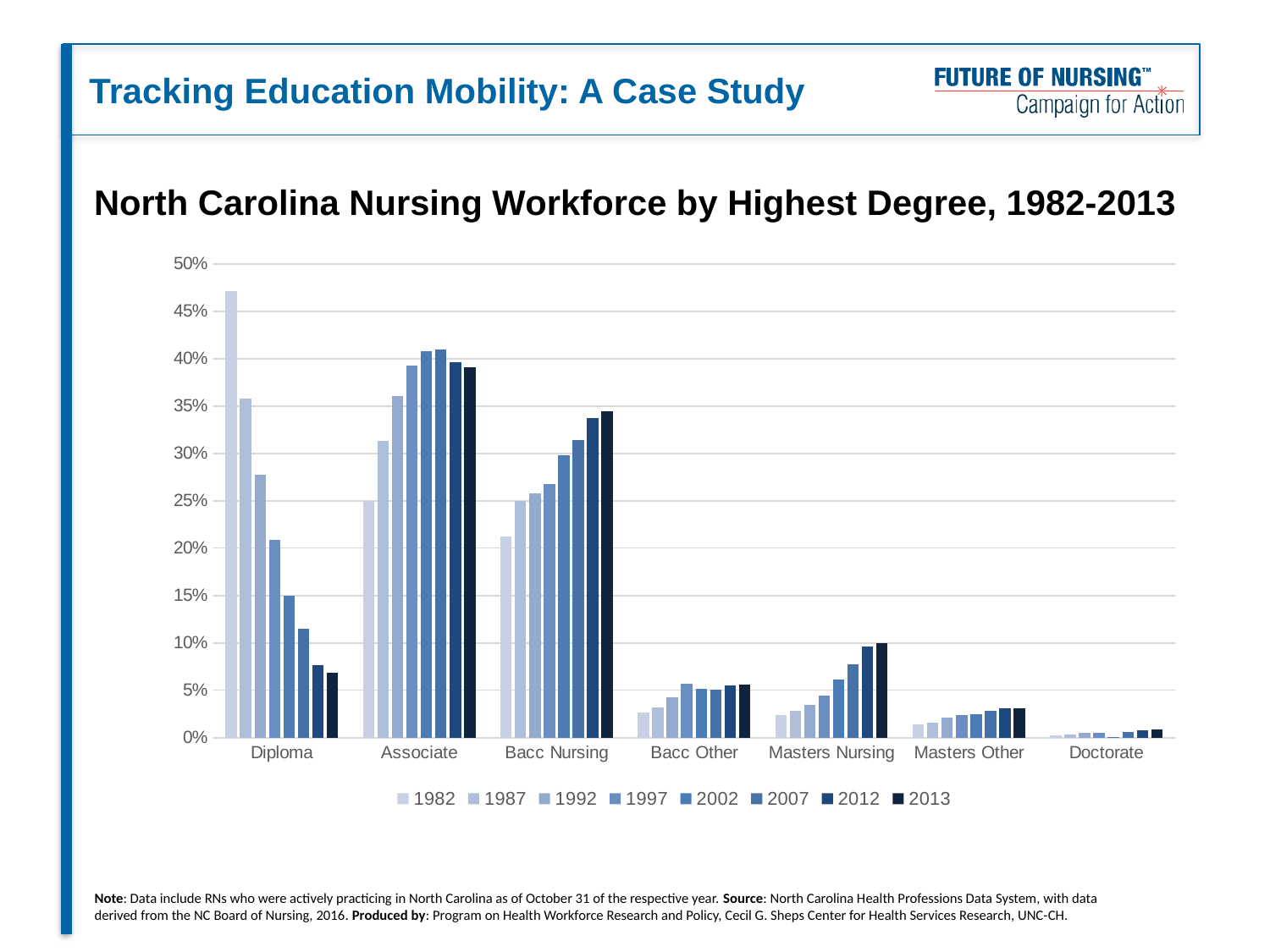
Do the Diploma values rise or fall from 1982 to 2013? fall Which degree category has the highest value in 1982? Diploma How many degree categories are shown on the x axis? 7 Do the Bacc Nursing values rise or fall from 1982 to 2013? rise Is the value for Associate in 2013 greater or less than 35%? greater What is the title of the chart? North Carolina Nursing Workforce by Highest Degree, 1982-2013 In 2013, which is larger: Masters Nursing or Bacc Other? Masters Nursing What kind of chart is shown on the slide? bar chart Is the value for Masters Nursing in 2013 greater or less than 5%? greater Is the value for Diploma in 1982 greater or less than 45%? greater How many years (series) does the legend list? 8 Which degree category has the lowest value in 2013? Doctorate